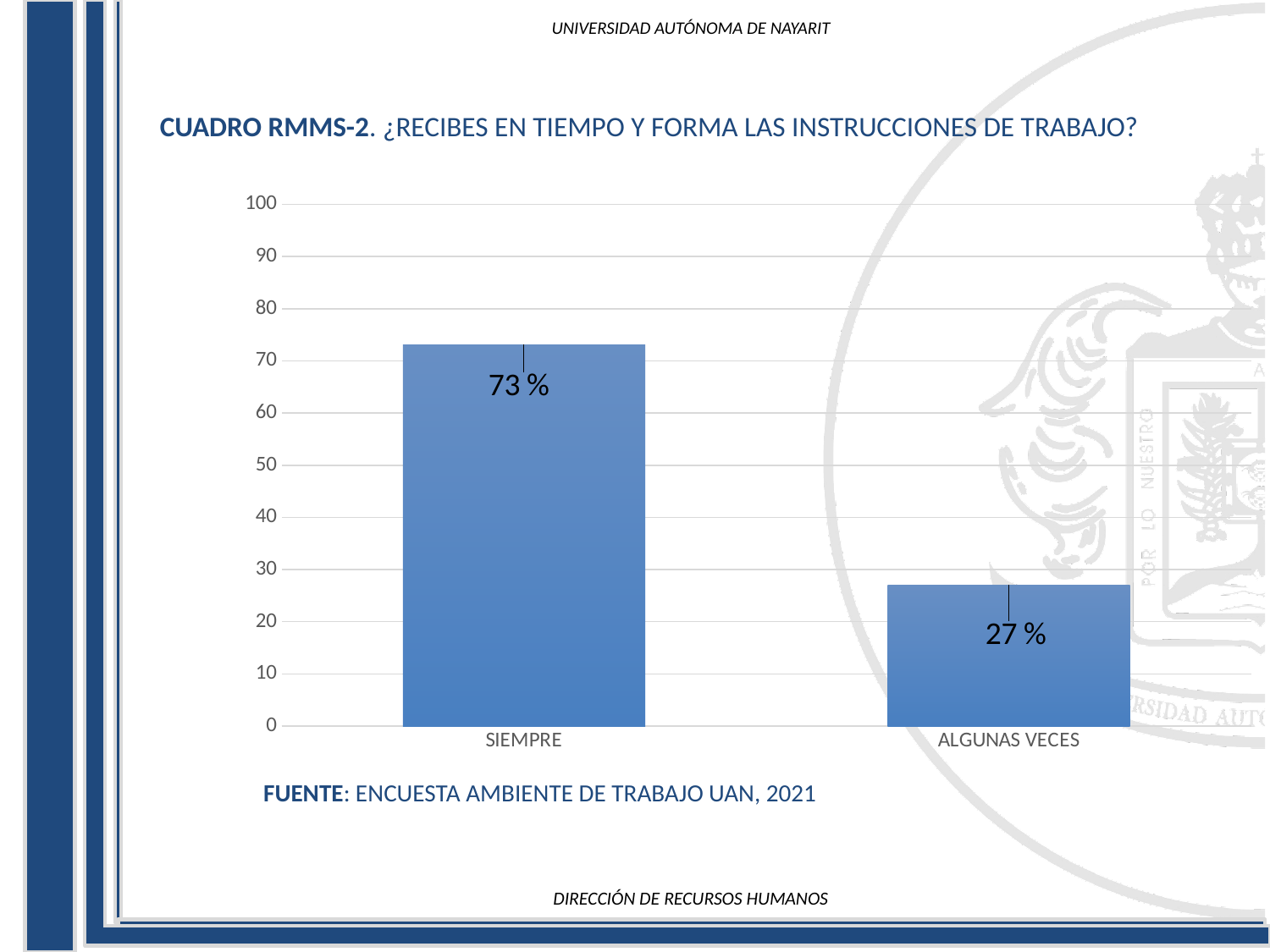
What is the value for SIEMPRE? 73 % Which category has the lowest value? ALGUNAS VECES What is the difference between the values for SIEMPRE and ALGUNAS VECES? 46 % Is the value for ALGUNAS VECES greater or less than 30? less Is the value for SIEMPRE greater or less than 70? greater Which is larger, the value for SIEMPRE or the value for ALGUNAS VECES? SIEMPRE What is the total of the two values shown on the chart? 100 % What is the value for ALGUNAS VECES? 27 % Which category has the highest value? SIEMPRE How many categories are shown on the chart? 2 What is the source cited below the chart? ENCUESTA AMBIENTE DE TRABAJO UAN, 2021 What kind of chart is shown on the slide? bar chart